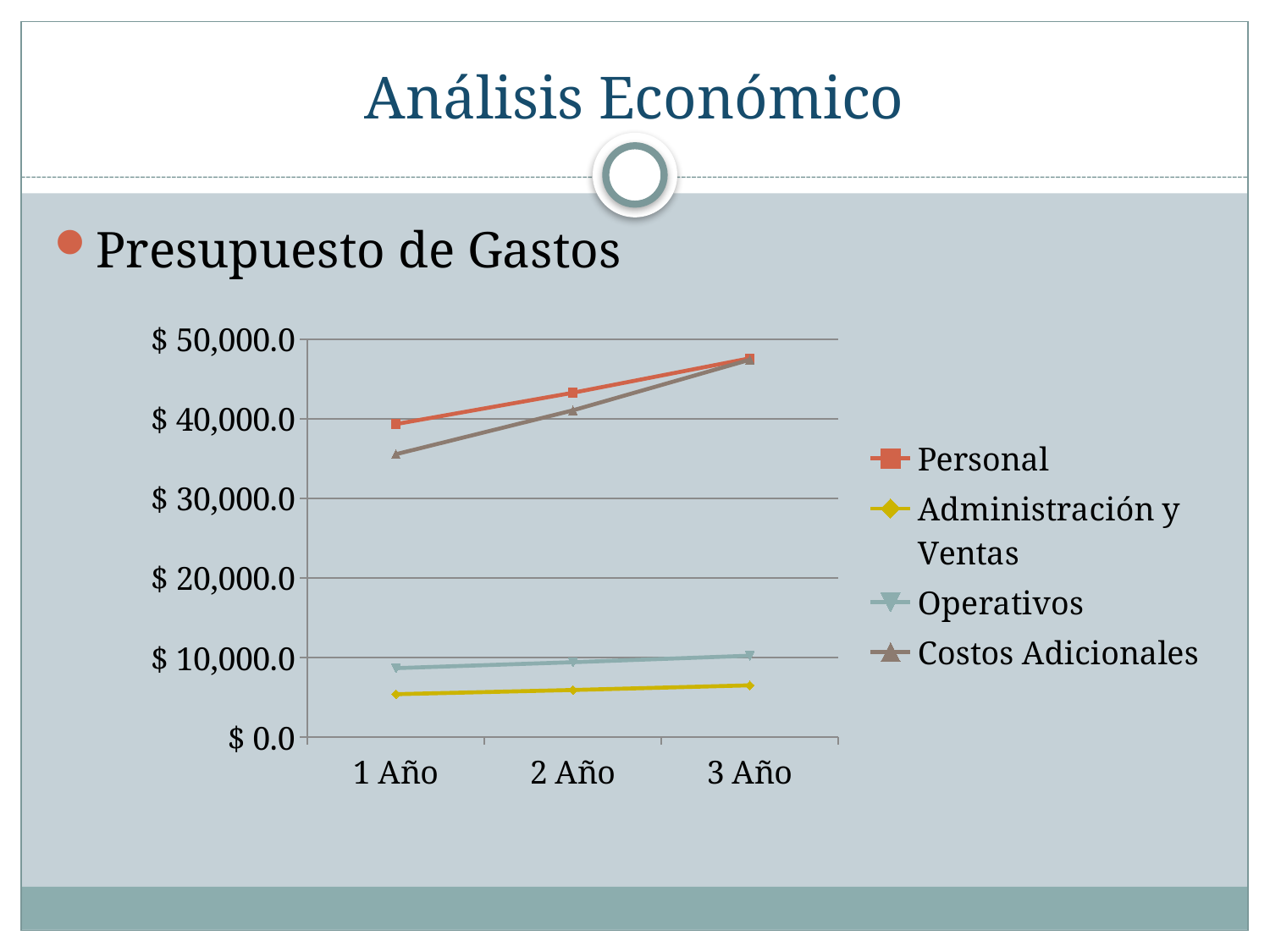
Is the value for Personal at 3 Año greater or less than $ 40,000.0? greater Which series is drawn with triangle markers pointing downward in the legend? Operativos Is the value for Costos Adicionales at 1 Año greater or less than $ 30,000.0? greater Which series has the highest value at 1 Año? Personal Do the values for Personal rise or fall from 1 Año to 3 Año? rise At 2 Año, which is larger: Operativos or Administración y Ventas? Operativos What kind of chart is shown on the slide? line chart Which series has the lowest value at 3 Año? Administración y Ventas Which series has the lowest value at 1 Año? Administración y Ventas How many categories are shown on the x axis of the chart? 3 Is the value for Operativos at 1 Año greater or less than $ 10,000.0? less How many series does the chart legend list? 4